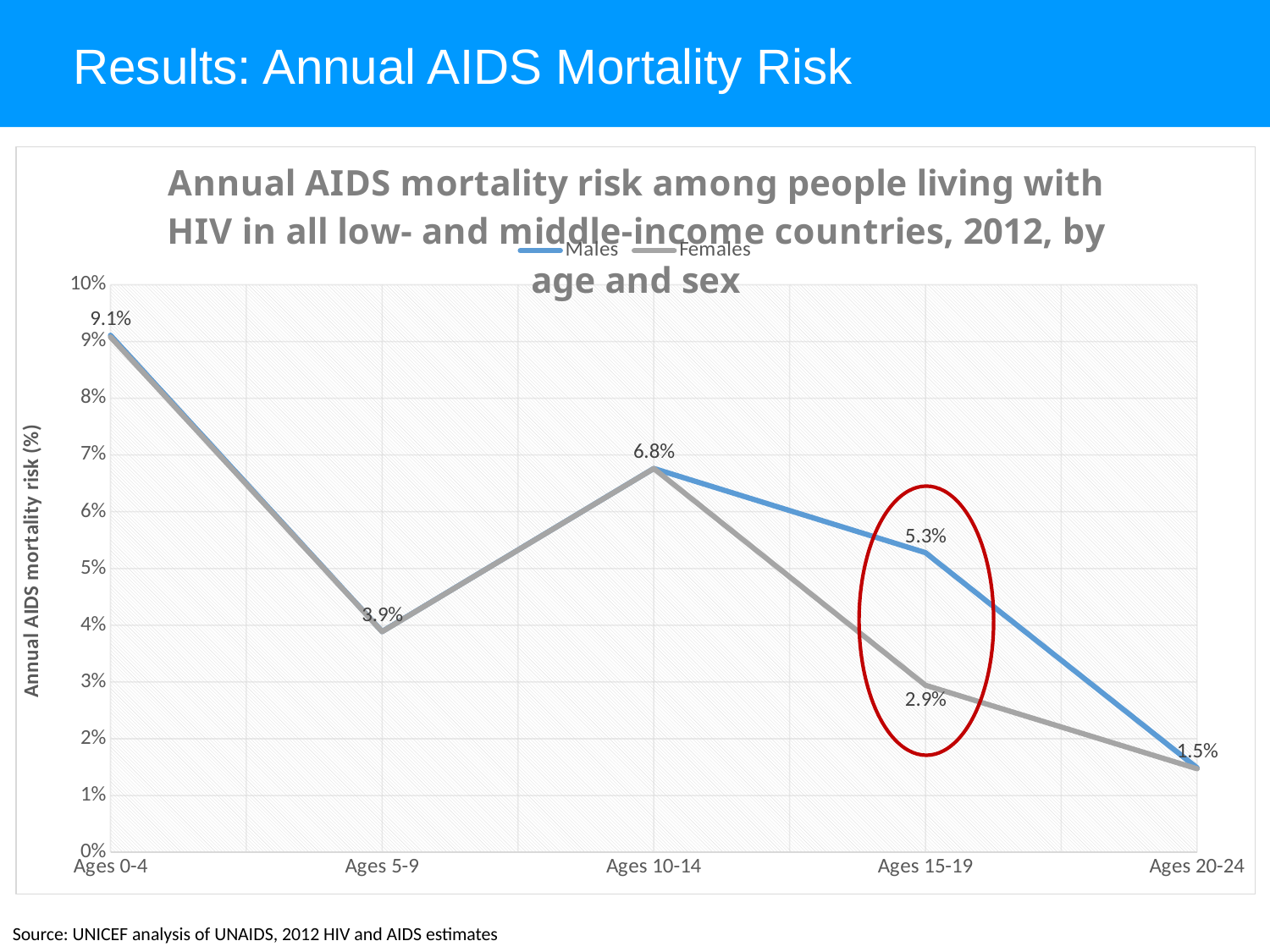
What is the difference between the Males and Females values at Ages 15-19? 2.4 percentage points What is the annual AIDS mortality risk at Ages 10-14? 6.8% What are the two entries in the chart's legend? Males and Females How many age groups are plotted along the x axis? 5 What kind of chart is shown on the slide? line chart Which age group has the lowest annual AIDS mortality risk? Ages 20-24 Does the Males line rise or fall from Ages 10-14 to Ages 20-24? fall At Ages 15-19, which series has the higher mortality risk, Males or Females? Males Which age group has the highest annual AIDS mortality risk? Ages 0-4 How many series does the legend list? 2 What is the annual AIDS mortality risk for Females at Ages 15-19? 2.9% What is the annual AIDS mortality risk for Males at Ages 15-19? 5.3%